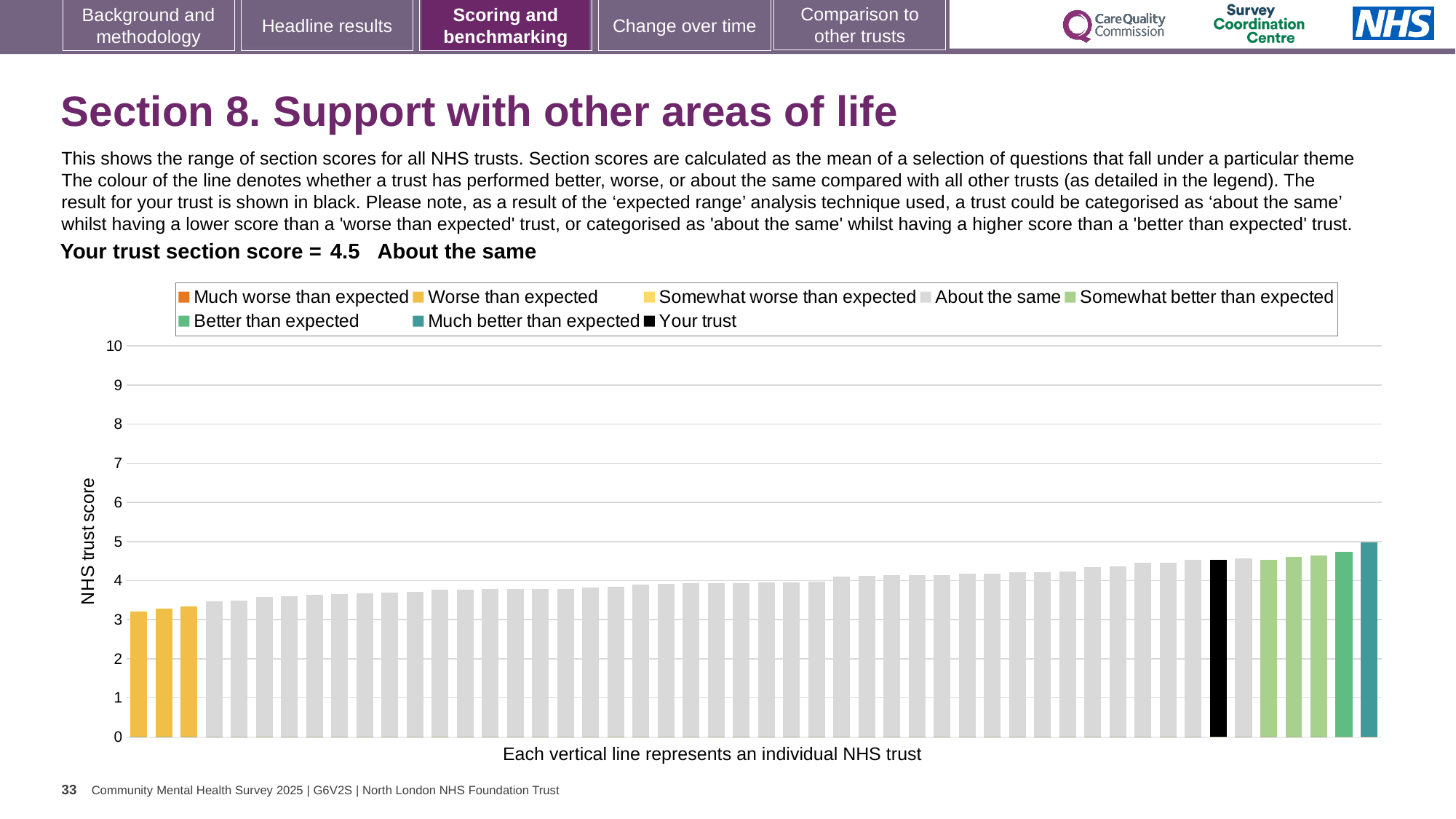
Which legend category does the highest bar on the chart belong to? Much better than expected Is the value of the black 'Your trust' bar greater or less than 4? greater What kind of chart is shown on the slide? bar chart How many bars are coloured as 'Worse than expected'? 3 How many entries does the chart legend list? 8 Is the value of the lowest bar on the chart greater or less than 3? greater Which category is your trust placed in for this section? About the same Do the bar values rise or fall from left to right along the x axis? rise What is the label on the y axis of the chart? NHS trust score What is the section score for your trust, as printed on the slide? 4.5 How many bars are coloured as 'Much better than expected'? 1 Is the value of the highest bar on the chart greater or less than 6? less